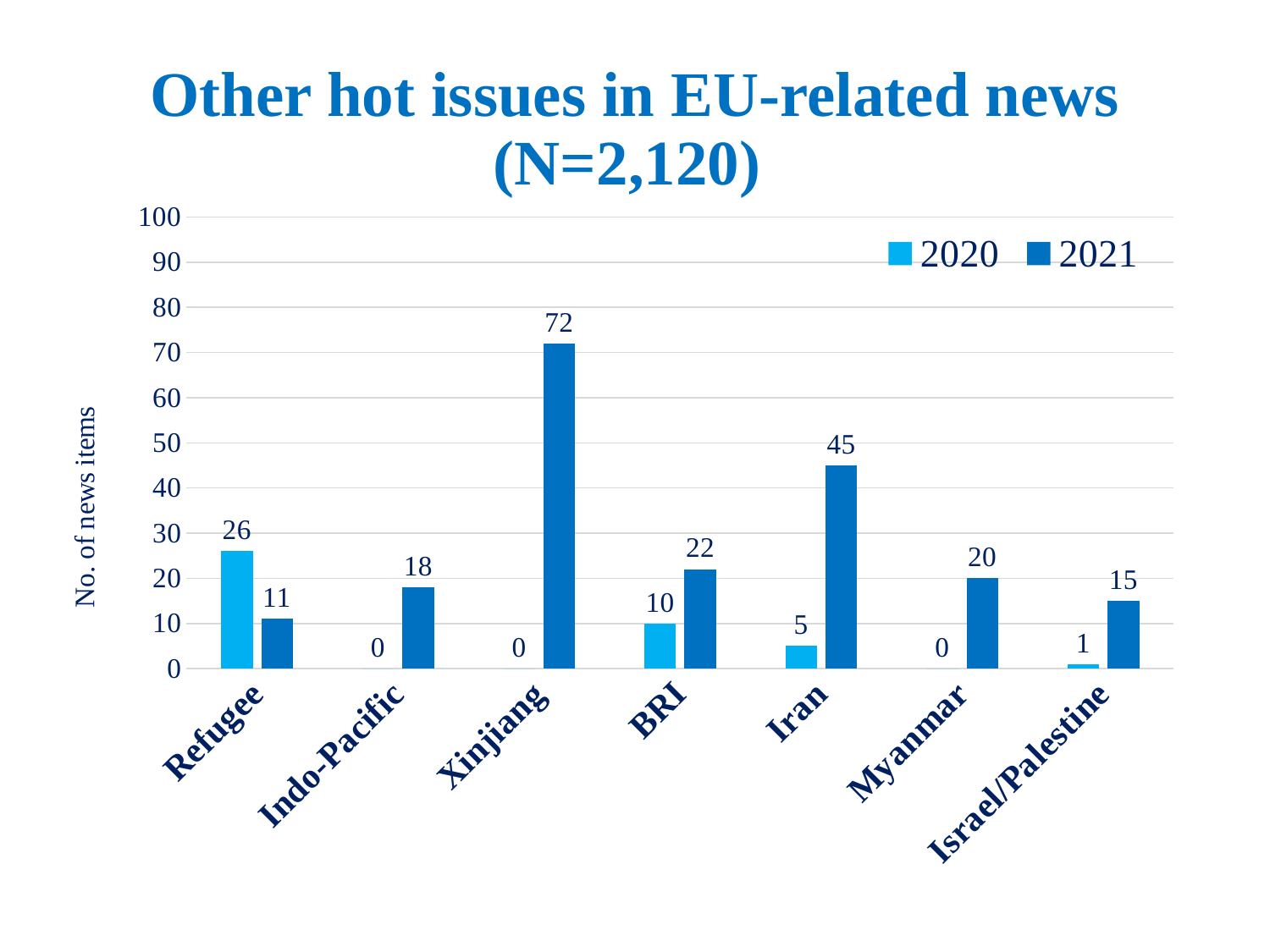
How many categories are shown on the x axis? 7 What is the 2021 value for Iran? 45 What is the label of the vertical axis? No. of news items Which is larger for Refugee, the 2020 value or the 2021 value? 2020 What kind of chart is shown on the slide? Bar chart Which category has the lowest 2021 value? Refugee What is the 2021 value for Xinjiang? 72 What is the 2020 value for Israel/Palestine? 1 How many series does the legend list? 2 Which category has the highest 2021 value? Xinjiang What is the 2020 value for Refugee? 26 What is the difference between the 2021 and 2020 values for BRI? 12